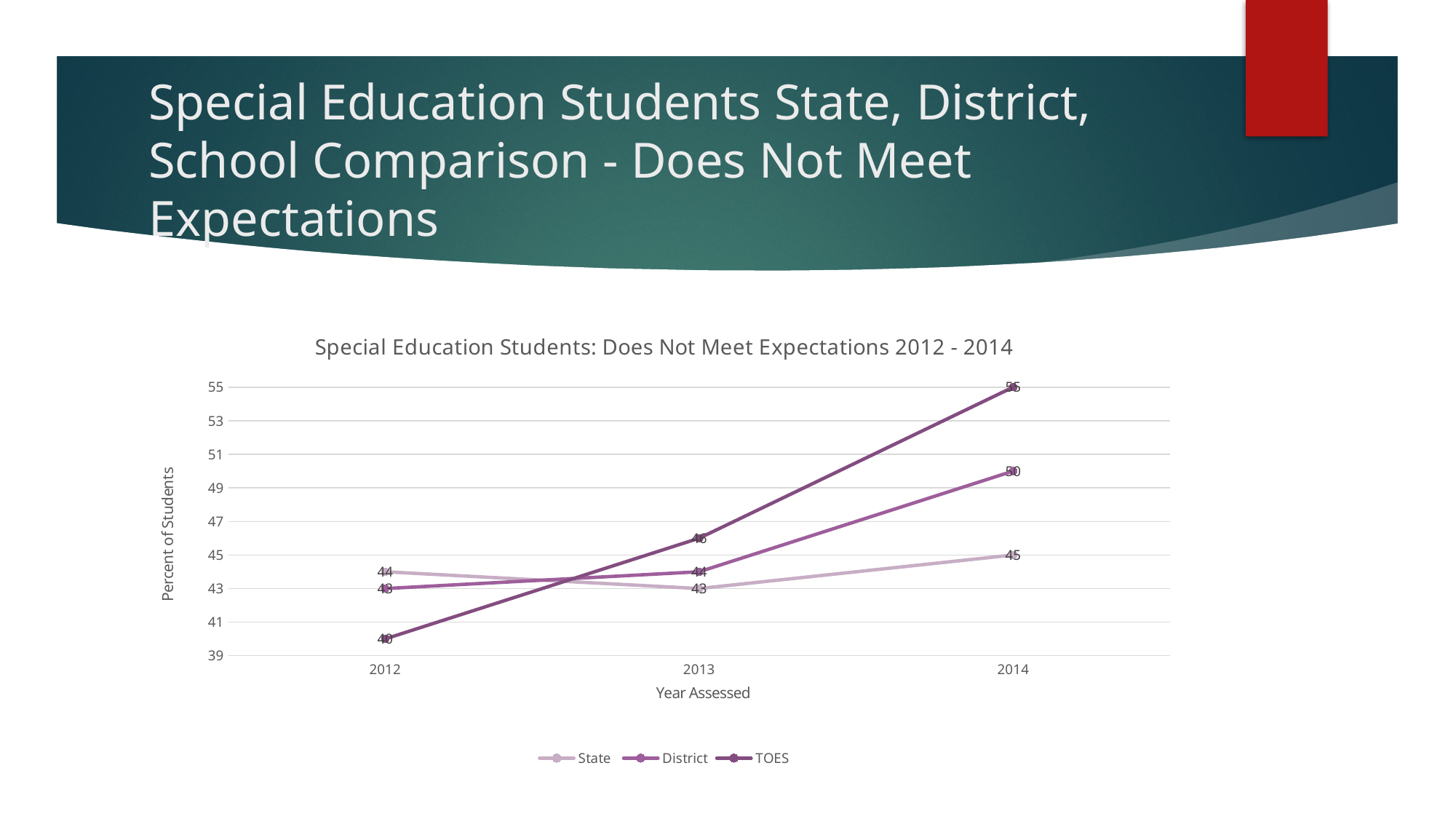
How many years are plotted on the x axis? 3 What is the State value for 2014? 45 In 2014, which is larger, the District value or the State value? District What is the TOES value for 2014? 55 Does the TOES series rise or fall from 2012 to 2014? Rise Which series has the lowest value in 2012? TOES What is the TOES value for 2012? 40 What kind of chart is shown on the slide? Line chart What is the difference between the TOES and State values in 2014? 10 Which series has the highest value in 2014? TOES What is the State value for 2013? 43 How many series does the legend list? 3